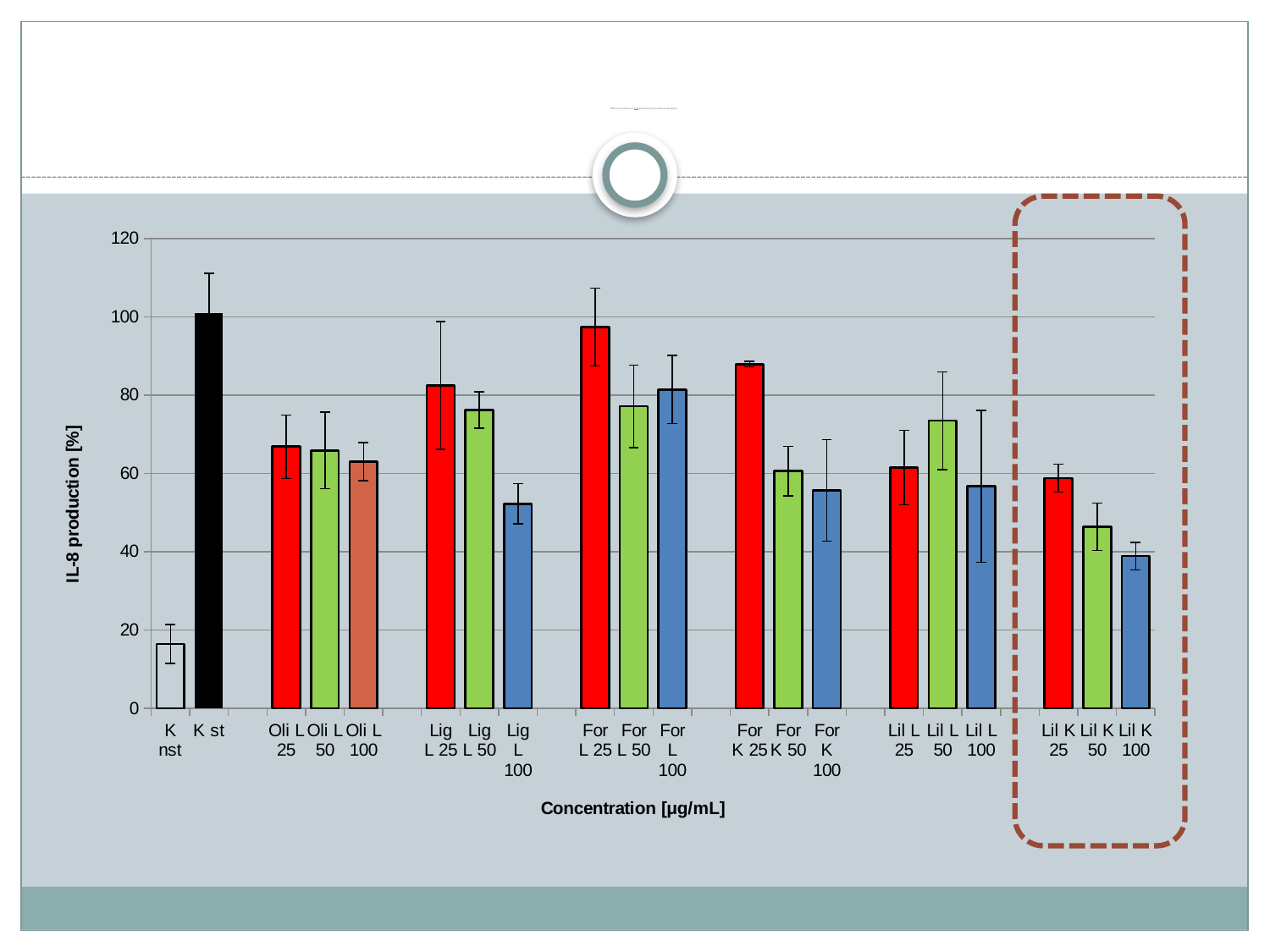
Is the value for For L 25 greater or less than 80? greater How many bars are plotted in the chart? 20 Is the value for Lil K 100 greater or less than 60? less What is the title of the y axis? IL-8 production [%] Is the value for K nst greater or less than 20? less Which category has the highest IL-8 production? K st Do the values rise or fall from Lil K 25 to Lil K 100? fall Which is larger, the value for For L 25 or the value for Lil K 100? For L 25 What kind of chart is shown on the slide? bar chart Which category has the lowest IL-8 production? K nst